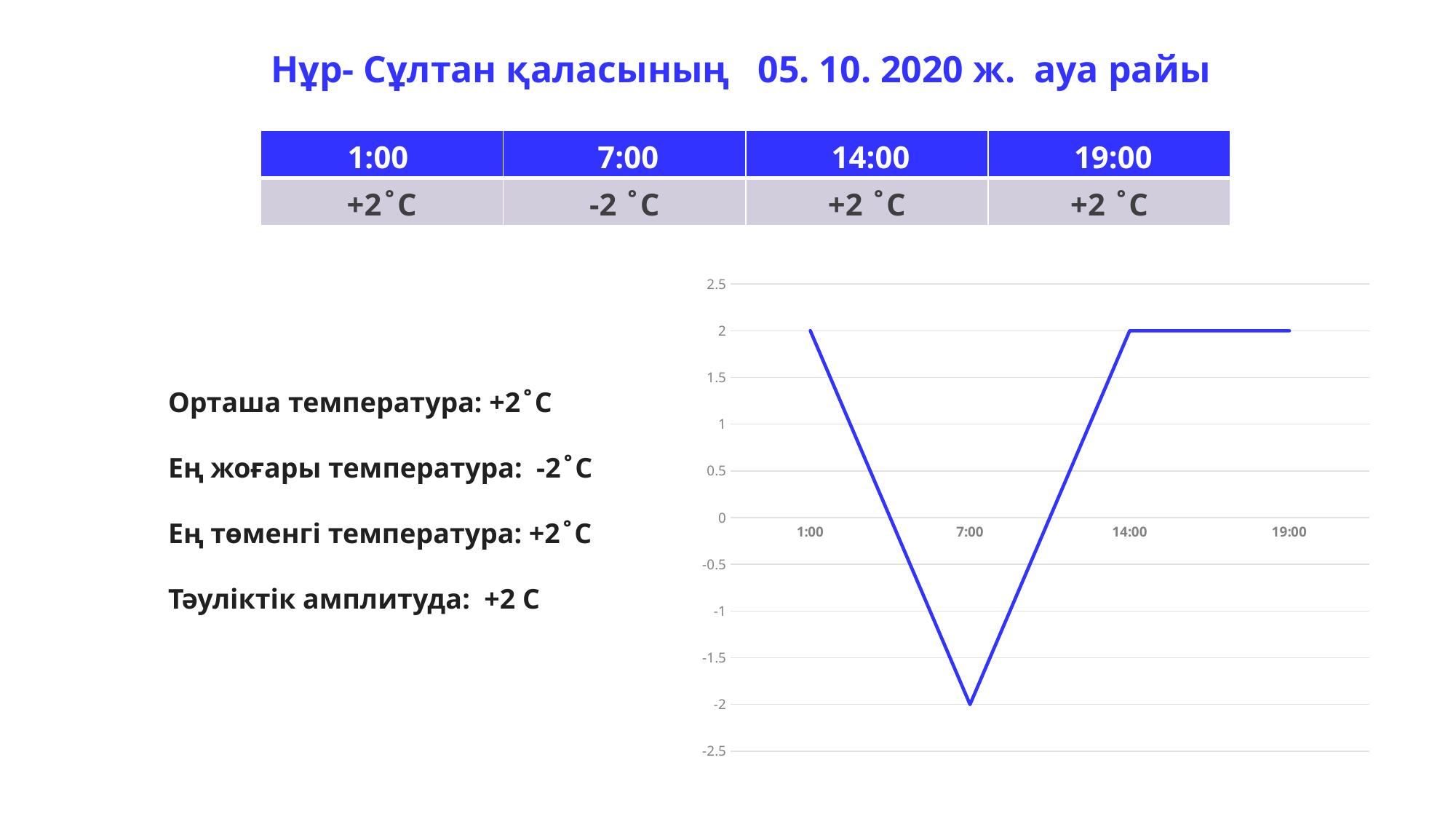
Does the line fall or rise between 1:00 and 7:00 on the chart? fall Which is larger on the line chart, the value at 1:00 or the value at 7:00? 1:00 What is the value plotted at 1:00 on the line chart? 2 What kind of chart is shown on the slide? line chart At which time point does the line chart reach its lowest value? 7:00 How many time points are plotted on the line chart? 4 Is the value at 7:00 on the line chart greater or less than 0? less What is the difference between the value at 14:00 and the value at 7:00 on the line chart? 4 What is the value plotted at 19:00 on the line chart? 2 Does the line rise, fall or stay flat between 14:00 and 19:00 on the chart? stay flat What is the value plotted at 7:00 on the line chart? -2 What is the highest value shown on the vertical axis of the line chart? 2.5